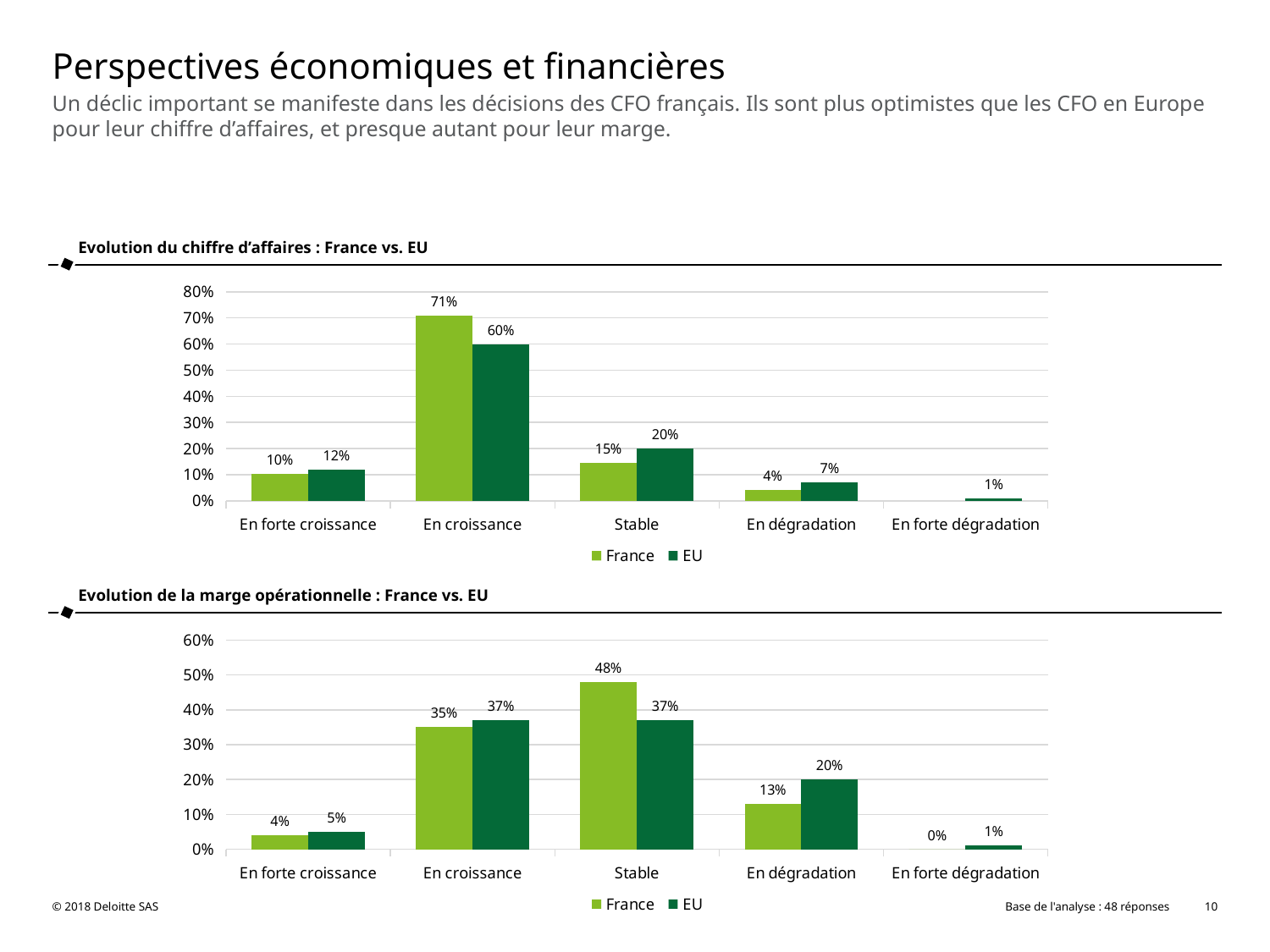
In the chart 'Evolution du chiffre d'affaires : France vs. EU', how many categories are shown on the x axis? 5 In the chart 'Evolution de la marge opérationnelle : France vs. EU', which category has the lowest value for EU? En forte dégradation How many series does the legend list in the chart 'Evolution de la marge opérationnelle : France vs. EU'? 2 In the chart 'Evolution du chiffre d'affaires : France vs. EU', what is the value for France in the 'En croissance' category? 71% In the chart 'Evolution de la marge opérationnelle : France vs. EU', what is the value for France in the 'Stable' category? 48% What type of chart is 'Evolution de la marge opérationnelle : France vs. EU'? Bar chart In the chart 'Evolution de la marge opérationnelle : France vs. EU', what is the value for EU in the 'En dégradation' category? 20% In the chart 'Evolution du chiffre d'affaires : France vs. EU', what is the difference between the France and EU values for 'En croissance'? 11% In the chart 'Evolution du chiffre d'affaires : France vs. EU', what is the value for EU in the 'Stable' category? 20% In the chart 'Evolution de la marge opérationnelle : France vs. EU', what is the difference between the France and EU values for 'Stable'? 11% In the chart 'Evolution du chiffre d'affaires : France vs. EU', which category has the highest value for France? En croissance In the chart 'Evolution du chiffre d'affaires : France vs. EU', which is larger for 'En dégradation', France or EU? EU